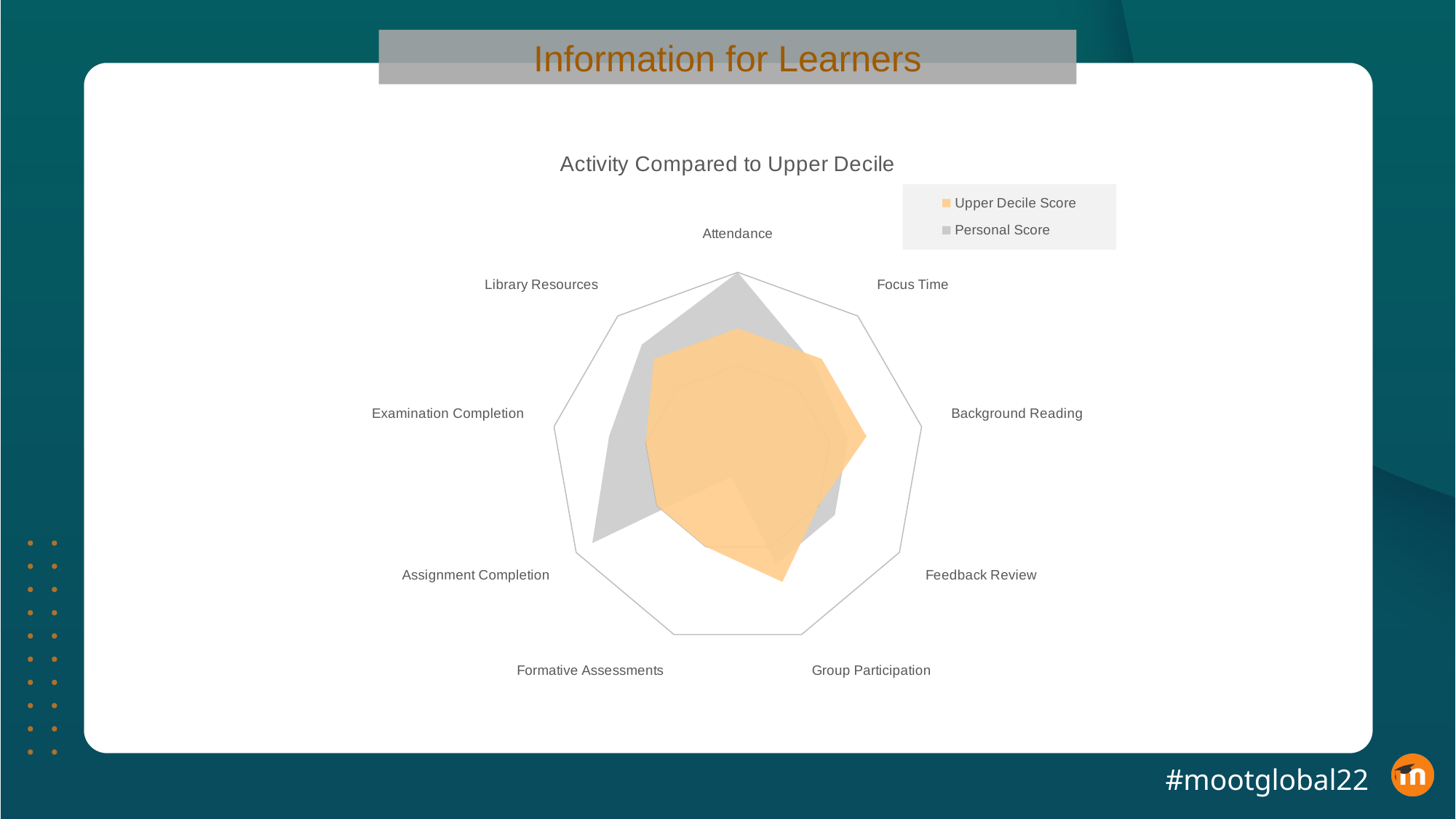
How many series does the legend list? 2 What are the two series named in the legend? Upper Decile Score and Personal Score What kind of chart is shown on the slide? Radar chart For Library Resources, which series has the larger value, Upper Decile Score or Personal Score? Personal Score For Attendance, which series has the larger value, Upper Decile Score or Personal Score? Personal Score For Assignment Completion, which series has the larger value, Upper Decile Score or Personal Score? Personal Score How many categories (axes) does the radar chart have? 9 Which category is the Personal Score series lowest in? Formative Assessments What is the title of the chart? Activity Compared to Upper Decile